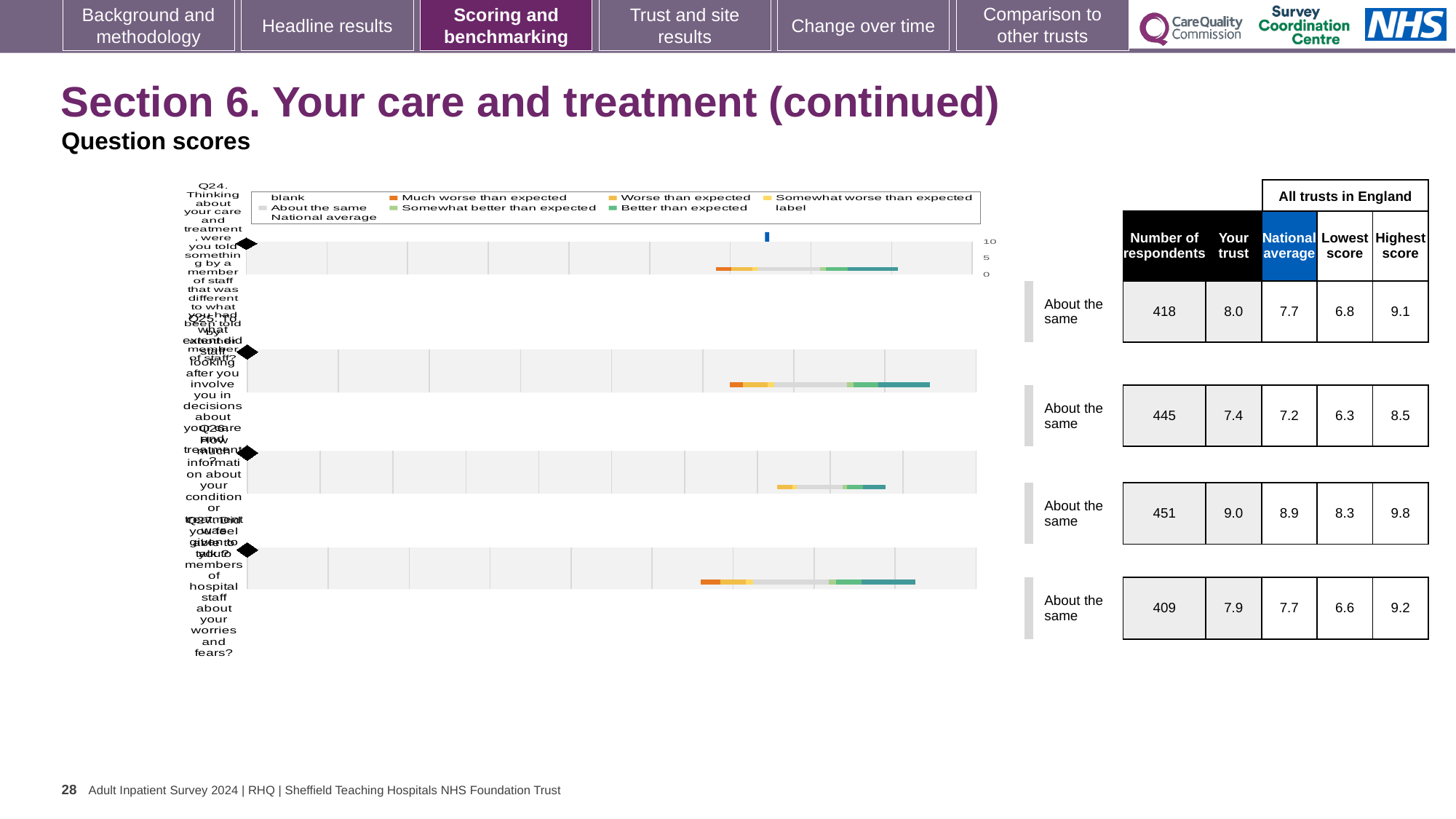
In the table, how many respondents are listed for the second row (Q25)? 445 In the table, what is the highest score across all trusts in England for the fourth row (Q27)? 9.2 What kind of chart is used to show the question scores on the left of the slide? bar chart In the table, what is the national average for the third row (Q26)? 8.9 Which row in the table has the fewest respondents? Q27 (fourth row), 409 In the table, what is the difference between the 'Your trust' score and the national average for the first row (Q24)? 0.3 In the table, what is the 'Your trust' score for the first row (Q24)? 8.0 In the chart legend, which colour represents 'Much worse than expected'? orange What is the benchmark category shown next to every question row in the chart? About the same Which row in the table has the highest 'Your trust' score? Q26 (third row), 9.0 For the second row (Q25), which is larger: the 'Your trust' score or the national average? Your trust How many question rows (Q24 to Q27) are plotted in the chart? 4